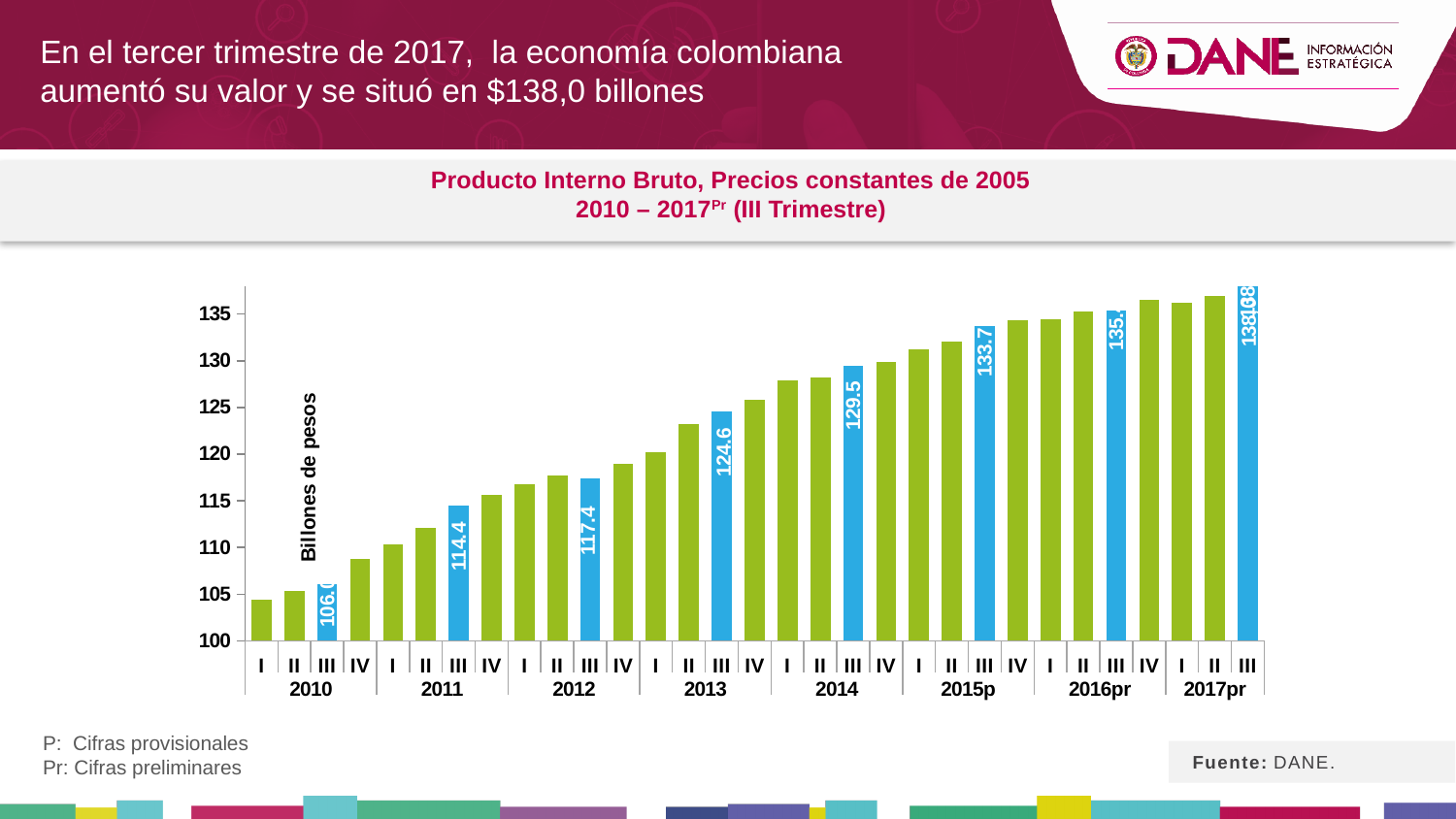
Which quarter has the highest value in the chart? III 2017pr What type of chart is shown on the slide? bar chart What is the value for the third quarter (III) of 2013? 124.6 What is the value for the third quarter (III) of 2014? 129.5 What is the difference between the third quarter of 2012 and the third quarter of 2011? 3.0 What is the label on the vertical axis of the chart? Billones de pesos Which quarter has the lowest value in the chart? I 2010 Do the values generally rise or fall from 2010 to 2017? rise What is the difference between the third quarter of 2014 and the third quarter of 2013? 4.9 What is the value for the third quarter (III) of 2011? 114.4 Is the value for the first quarter (I) of 2010 greater or less than 105? less What is the value for the third quarter (III) of 2015p? 133.7